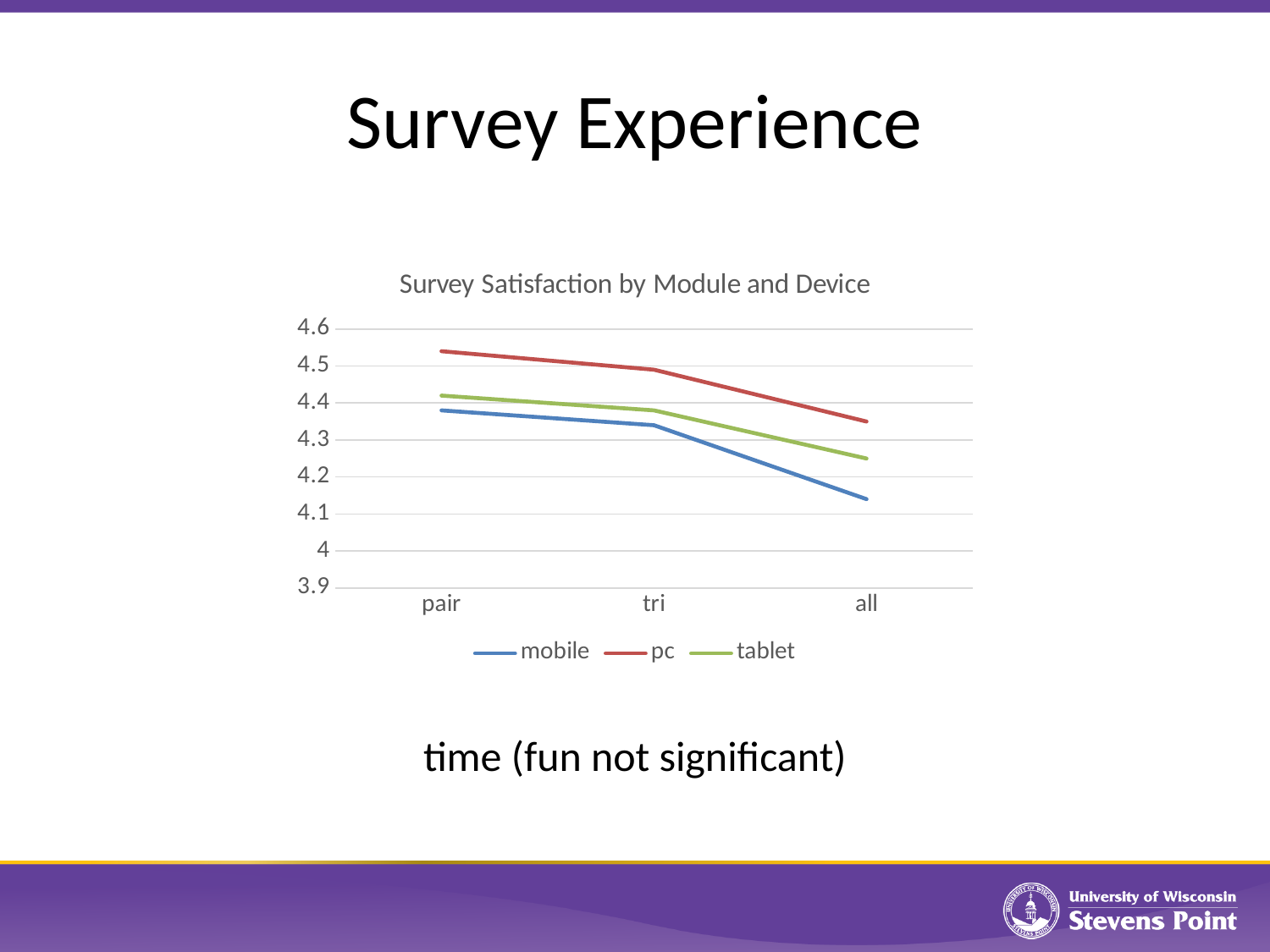
Does the mobile series rise or fall from "pair" to "all"? fall How many categories are shown on the x axis? 3 Is the value for pc at "pair" greater or less than 4.5? greater Which series has the highest value at "all"? pc How many series does the legend list? 3 What kind of chart is shown on the slide? line chart Is the value for mobile at "all" greater or less than 4.2? less Which series has the highest value at "pair"? pc Is the value for tablet at "all" greater or less than 4.2? greater Which series has the lowest value at "all"? mobile What is the title of the chart? Survey Satisfaction by Module and Device Which colour is used for the pc series? red